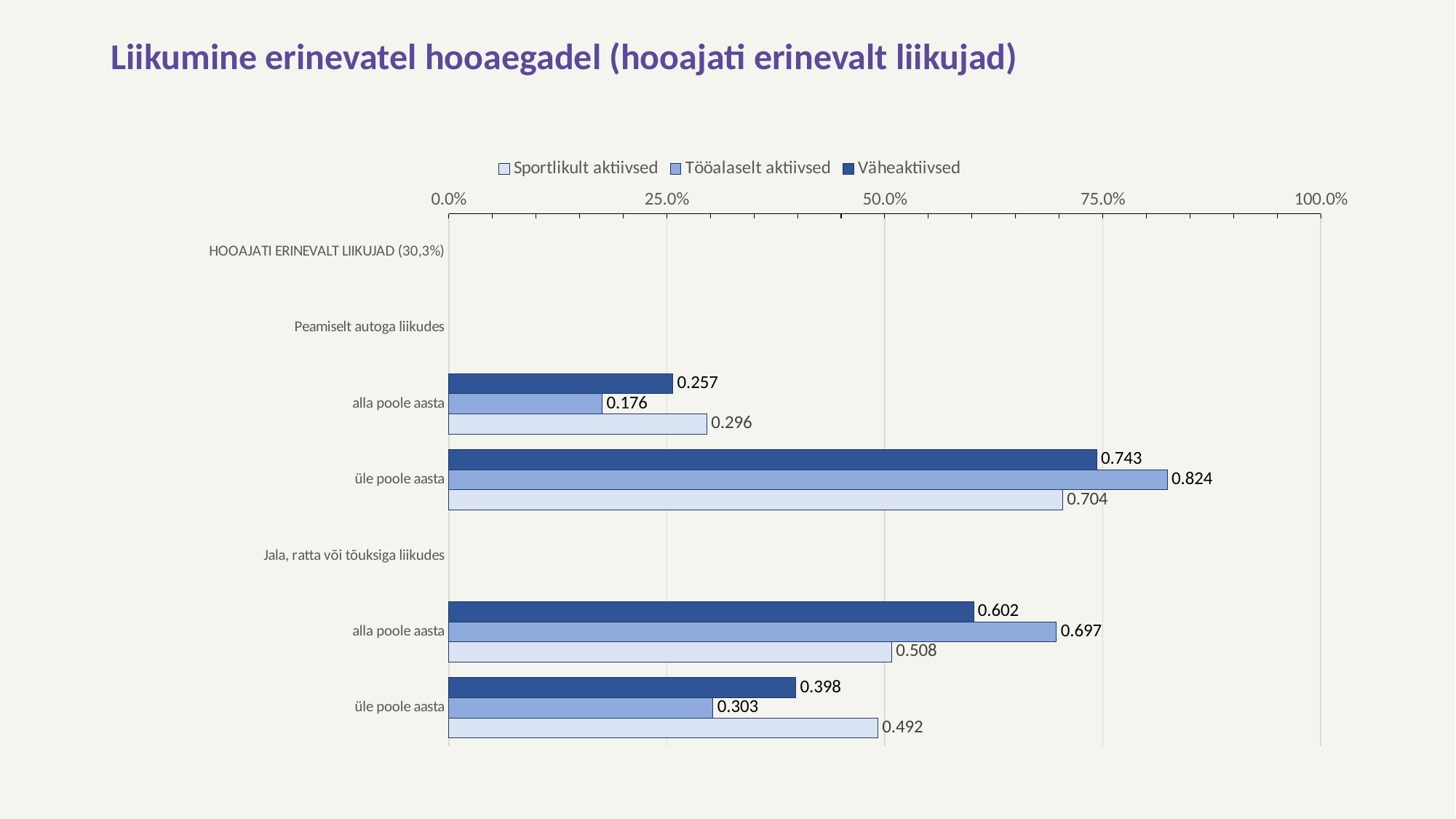
What is the value for Väheaktiivsed in the 'üle poole aasta' row under 'Jala, ratta või tõuksiga liikudes'? 0.398 How many series does the legend list? 3 Is the Väheaktiivsed value in the 'üle poole aasta' row under 'Peamiselt autoga liikudes' greater or less than 50.0%? greater What is the value for Tööalaselt aktiivsed in the 'üle poole aasta' row under 'Peamiselt autoga liikudes'? 0.824 What type of chart is shown on the slide? bar chart What is the difference between the Väheaktiivsed and Tööalaselt aktiivsed values in the 'alla poole aasta' row under 'Peamiselt autoga liikudes'? 0.081 Which series has the lowest value in the 'alla poole aasta' row under 'Peamiselt autoga liikudes'? Tööalaselt aktiivsed Which series has the highest value in the 'alla poole aasta' row under 'Jala, ratta või tõuksiga liikudes'? Tööalaselt aktiivsed What is the value for Sportlikult aktiivsed in the 'alla poole aasta' row under 'Jala, ratta või tõuksiga liikudes'? 0.508 What is the title of the chart on the slide? Liikumine erinevatel hooaegadel (hooajati erinevalt liikujad) What is the difference between the Tööalaselt aktiivsed and Sportlikult aktiivsed values in the 'üle poole aasta' row under 'Peamiselt autoga liikudes'? 0.120 In the 'üle poole aasta' row under 'Jala, ratta või tõuksiga liikudes', which is larger: Sportlikult aktiivsed or Tööalaselt aktiivsed? Sportlikult aktiivsed